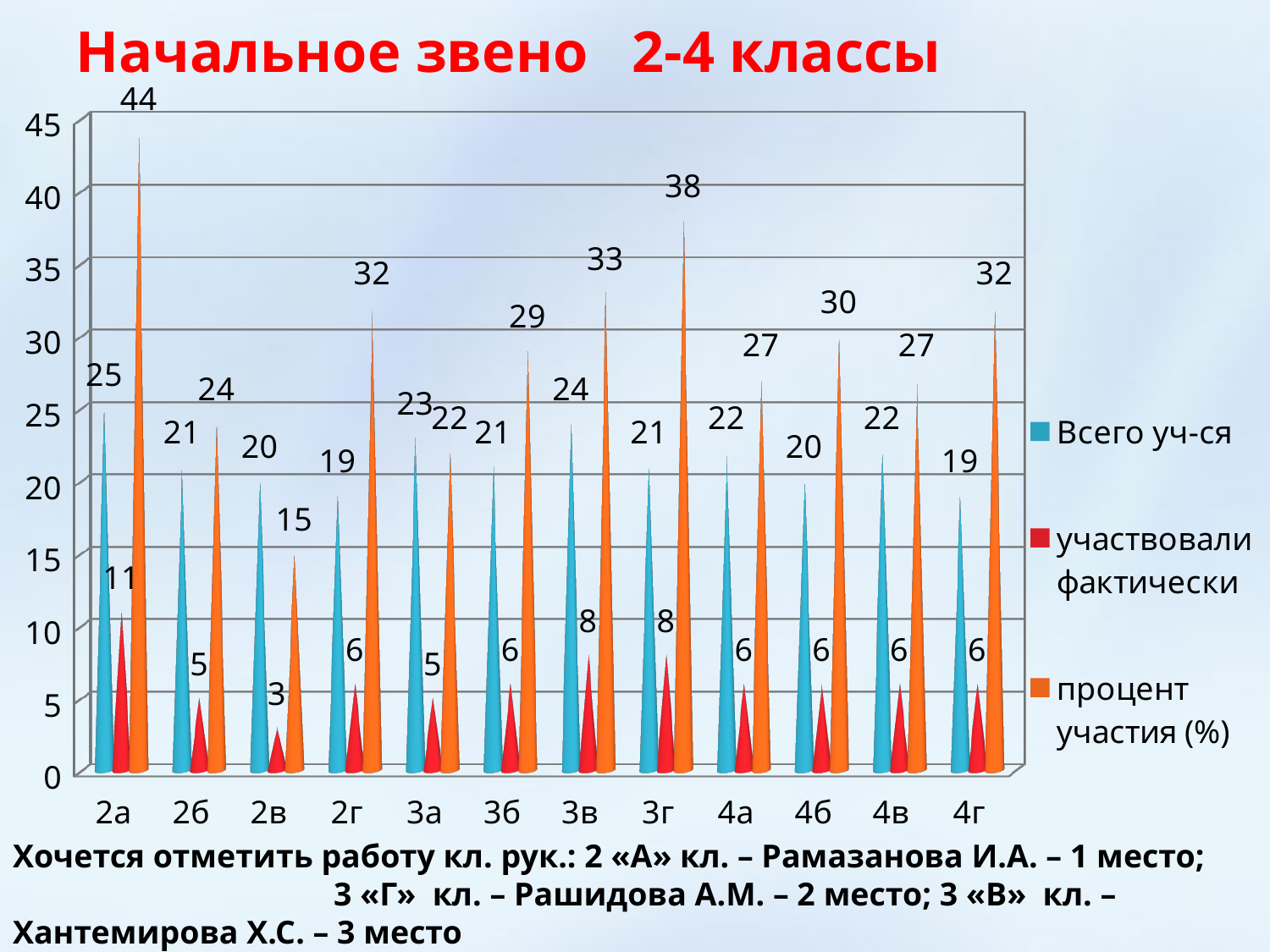
Which class has the lowest 'процент участия (%)'? 2в How many series does the legend list? 3 Which colour represents 'процент участия (%)' in the legend? orange Which class has the highest 'процент участия (%)'? 2а What kind of chart is shown on the slide? bar chart Which is larger: 'процент участия (%)' for 3г or for 3в? 3г Which class has the highest 'участвовали фактически' value? 2а What is the value of 'Всего уч-ся' for class 3в? 24 What is the difference between 'Всего уч-ся' and 'участвовали фактически' for class 3г? 13 What is the value of 'участвовали фактически' for class 2в? 3 How many classes are shown on the x axis? 12 What is the value of 'процент участия (%)' for class 2а? 44